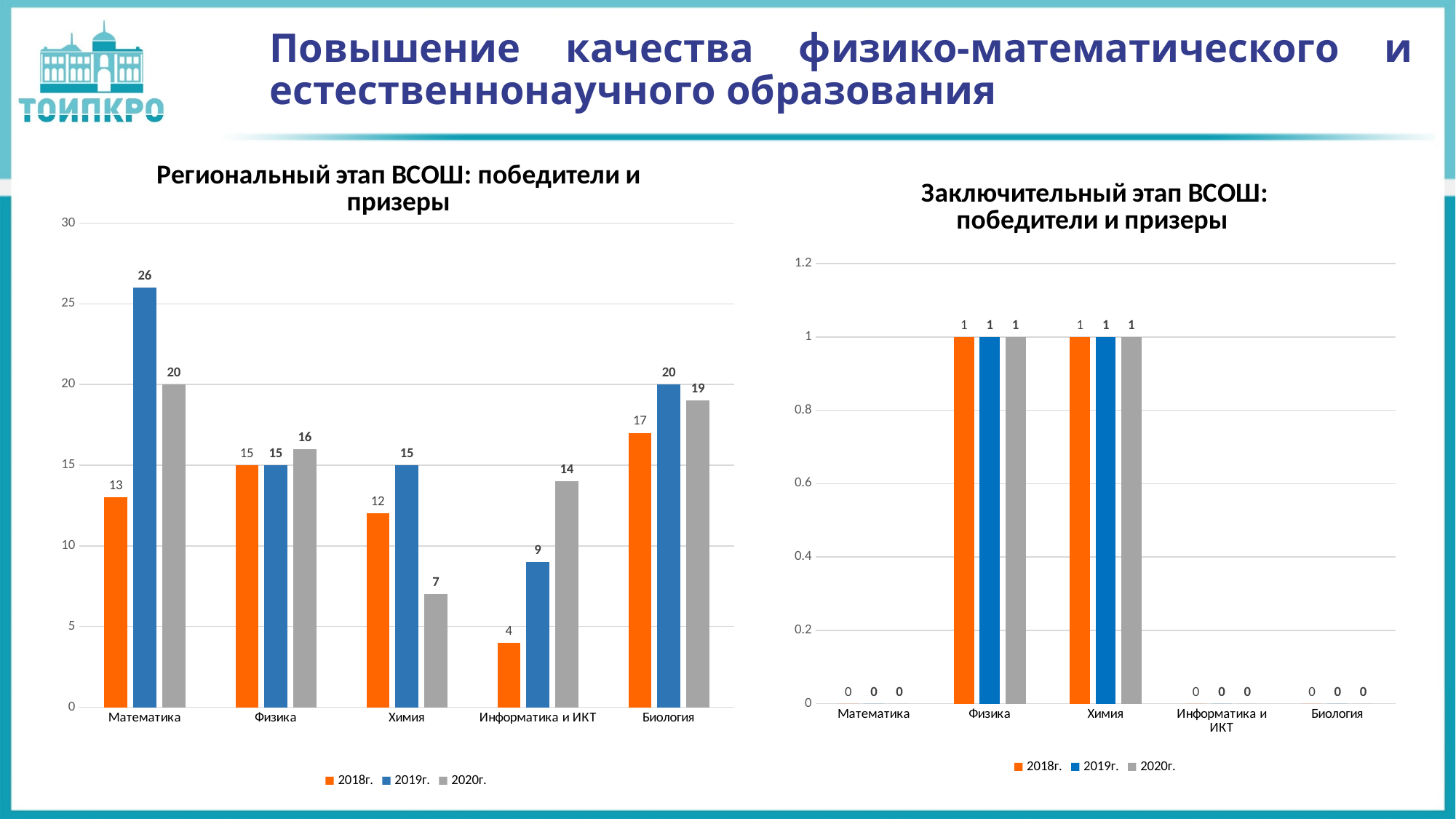
In the left chart 'Региональный этап ВСОШ: победители и призеры', how many series does the legend list? 3 In the left chart 'Региональный этап ВСОШ: победители и призеры', which colour represents the 2018г. series? orange In the left chart 'Региональный этап ВСОШ: победители и призеры', which category has the highest value for 2019г.? Математика In the left chart 'Региональный этап ВСОШ: победители и призеры', what is the difference between the 2020г. and 2018г. values for Информатика и ИКТ? 10 In the left chart 'Региональный этап ВСОШ: победители и призеры', what is the value for Математика in 2019г.? 26 In the right chart 'Заключительный этап ВСОШ: победители и призеры', what is the value for Химия in 2020г.? 1 In the left chart 'Региональный этап ВСОШ: победители и призеры', which category has the lowest value for 2020г.? Химия What kind of chart is the right chart 'Заключительный этап ВСОШ: победители и призеры'? bar chart In the left chart 'Региональный этап ВСОШ: победители и призеры', which is larger for Биология: the 2019г. value or the 2020г. value? 2019г. In the left chart 'Региональный этап ВСОШ: победители и призеры', what is the value for Информатика и ИКТ in 2018г.? 4 In the left chart 'Региональный этап ВСОШ: победители и призеры', how many categories are shown on the x axis? 5 In the right chart 'Заключительный этап ВСОШ: победители и призеры', what is the value for Биология in 2018г.? 0